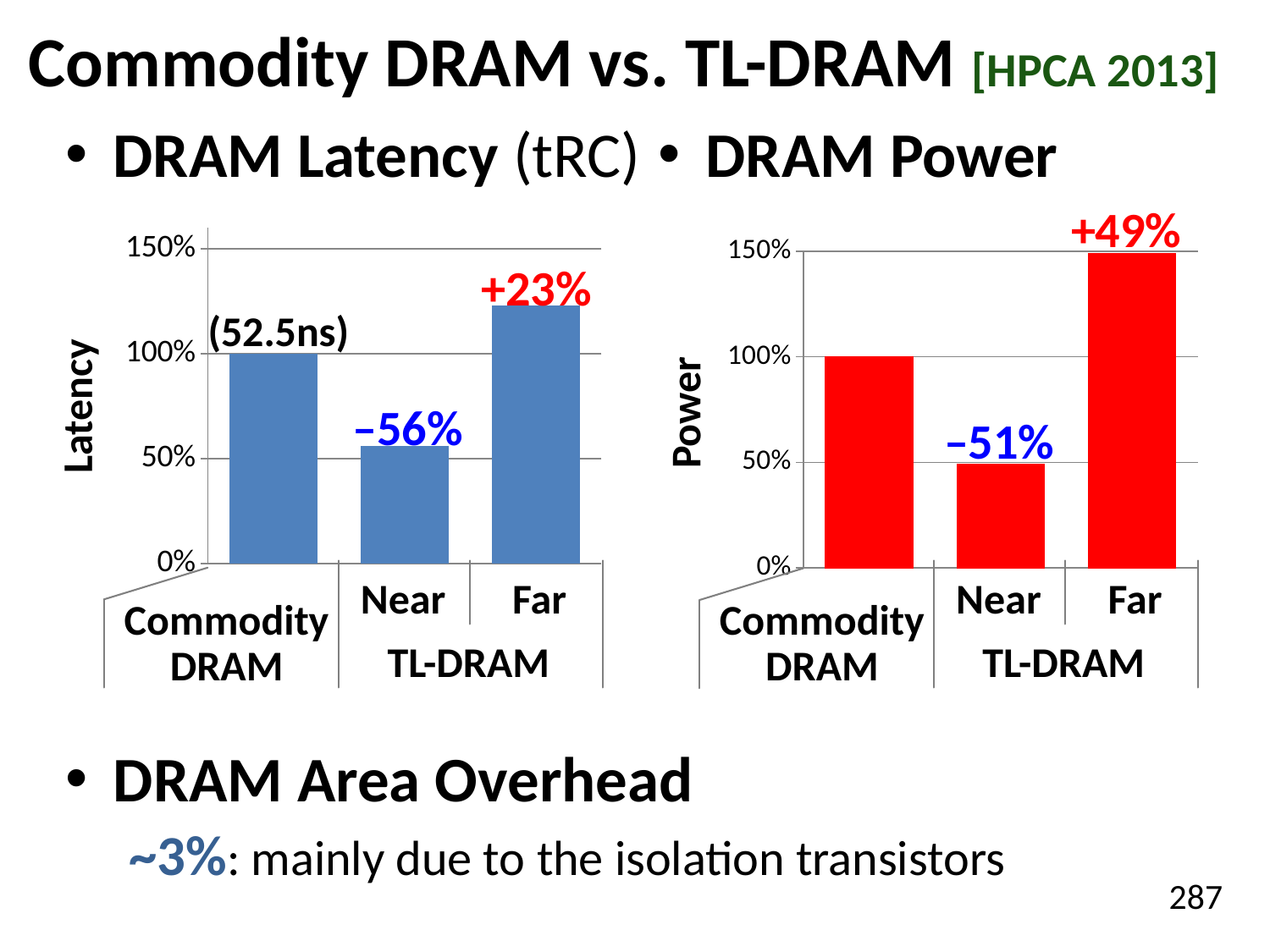
On the DRAM Latency chart, is the value for Near greater or less than 50%? greater What type of chart is the DRAM Power chart? Bar chart On the DRAM Power chart, what percentage change is labeled above the Near bar? –51% On the DRAM Latency chart, what absolute latency value is printed next to the Commodity DRAM bar? 52.5ns On the DRAM Latency chart, what percentage change is labeled above the Far bar? +23% On the DRAM Latency chart, which bar is the highest? Far On the DRAM Power chart, is the value for Far greater or less than 100%? greater On the DRAM Power chart, which is larger, the Commodity DRAM bar or the Near bar? Commodity DRAM On the DRAM Power chart, which bar is the lowest? Near On the DRAM Latency chart, what percentage change is labeled above the Near bar? –56% How many bars are plotted on the DRAM Latency chart? 3 On the DRAM Power chart, what percentage change is labeled above the Far bar? +49%